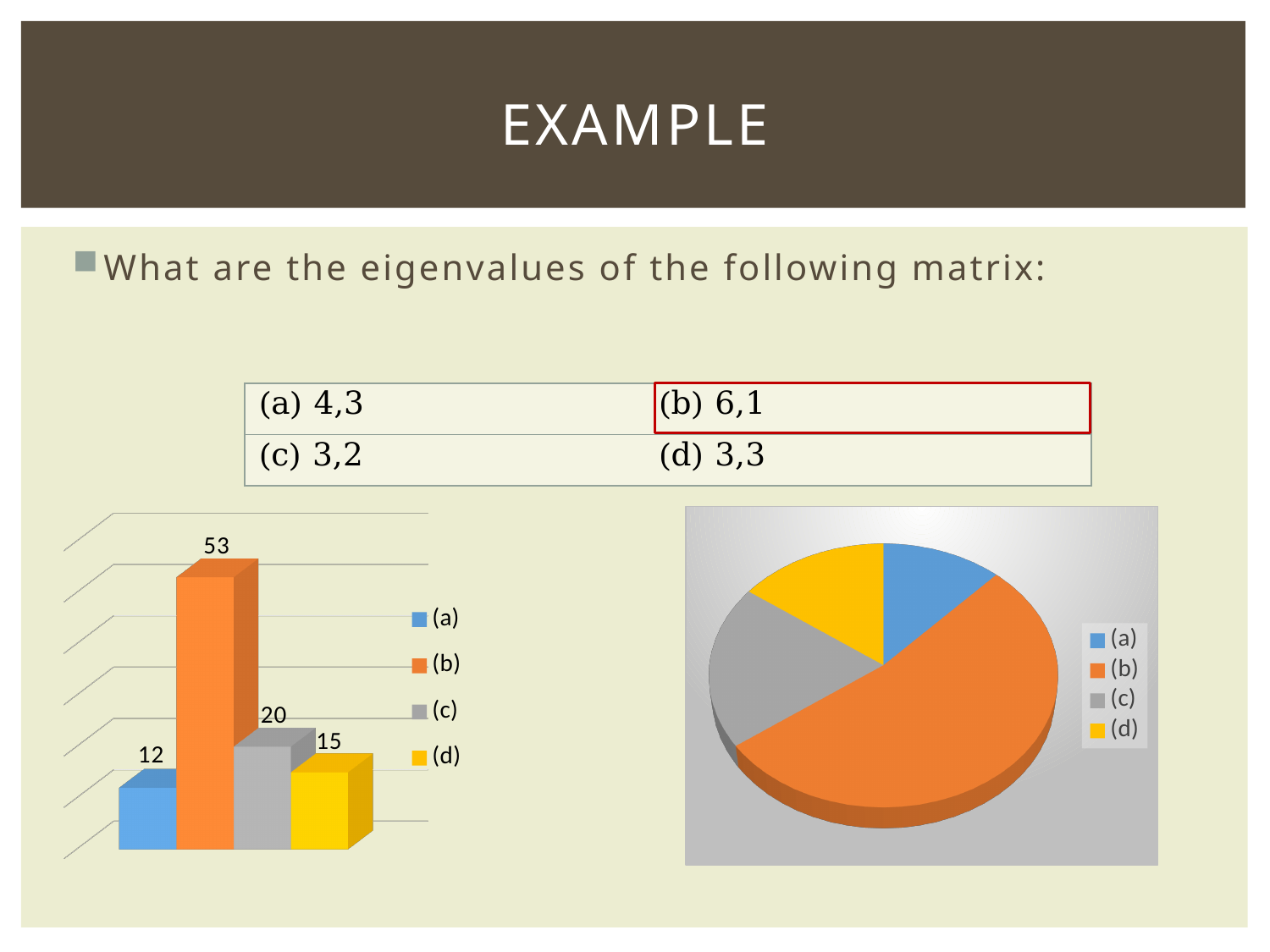
In the bar chart on the left, which category has the highest value? (b) In the bar chart on the left, which category has the lowest value? (a) What kind of chart is on the right of the slide? pie chart What kind of chart is on the left of the slide? bar chart In the bar chart on the left, what is the value for (a)? 12 In the pie chart on the right, which category has the largest slice? (b) How many categories are shown in the bar chart on the left? 4 In the bar chart on the left, what is the value for (c)? 20 In the bar chart on the left, what is the value for (d)? 15 In the bar chart on the left, what is the value for (b)? 53 In the bar chart on the left, what is the difference between the values for (b) and (c)? 33 In the bar chart on the left, which is larger, the value for (c) or the value for (d)? (c)